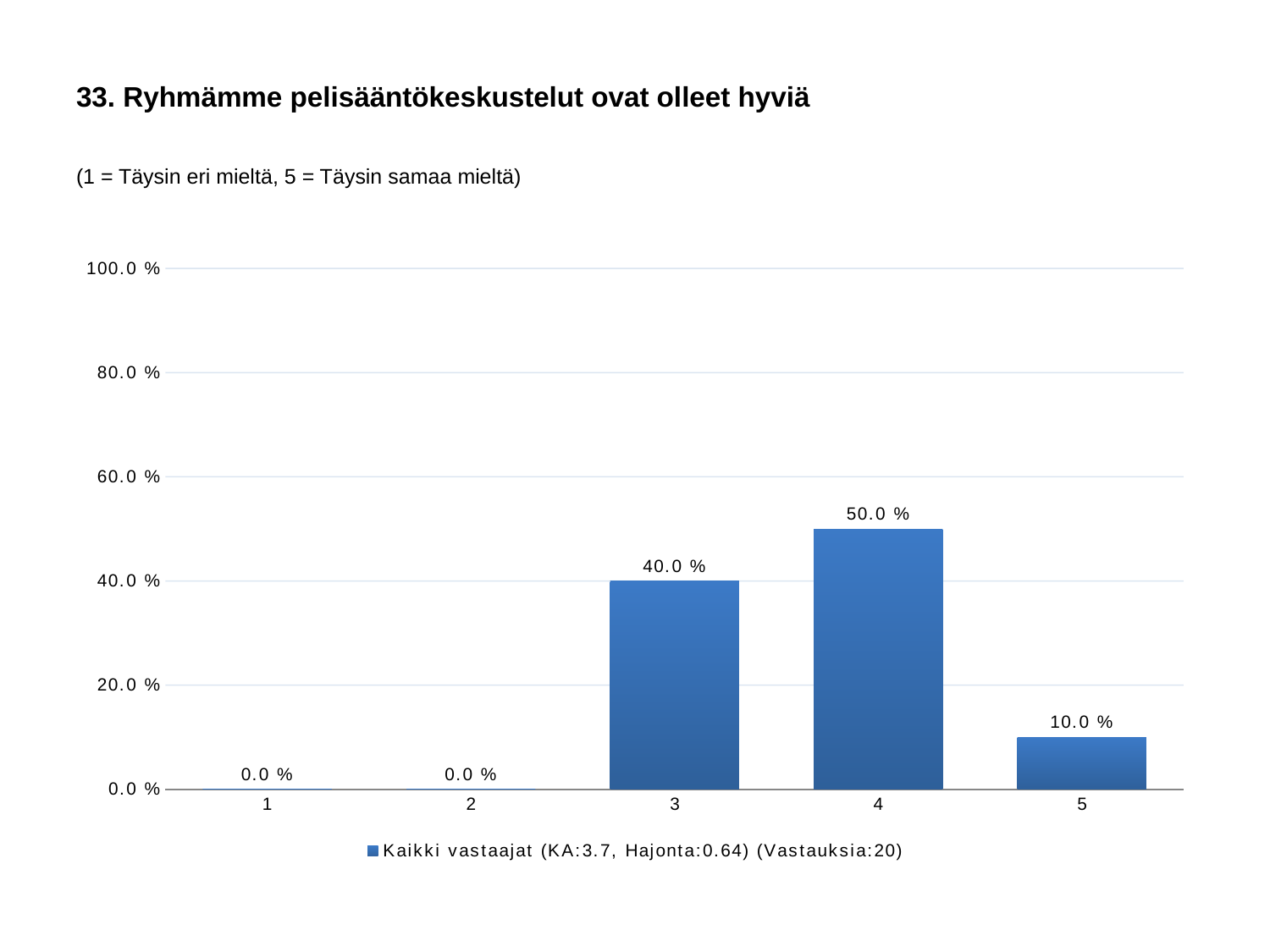
What is the difference between the values for categories 4 and 3? 10.0 % What is the value for category 1? 0.0 % Which is larger, the value for category 3 or the value for category 5? 3 How many categories are shown on the x axis? 5 Which category has the highest value? 4 What is the number of responses (Vastauksia) given in the legend? 20 What is the value for category 4? 50.0 % What kind of chart is shown on the slide? bar chart What is the value for category 3? 40.0 % Is the value for category 4 greater or less than 60.0 %? less How many series does the legend list? 1 What is the value for category 5? 10.0 %